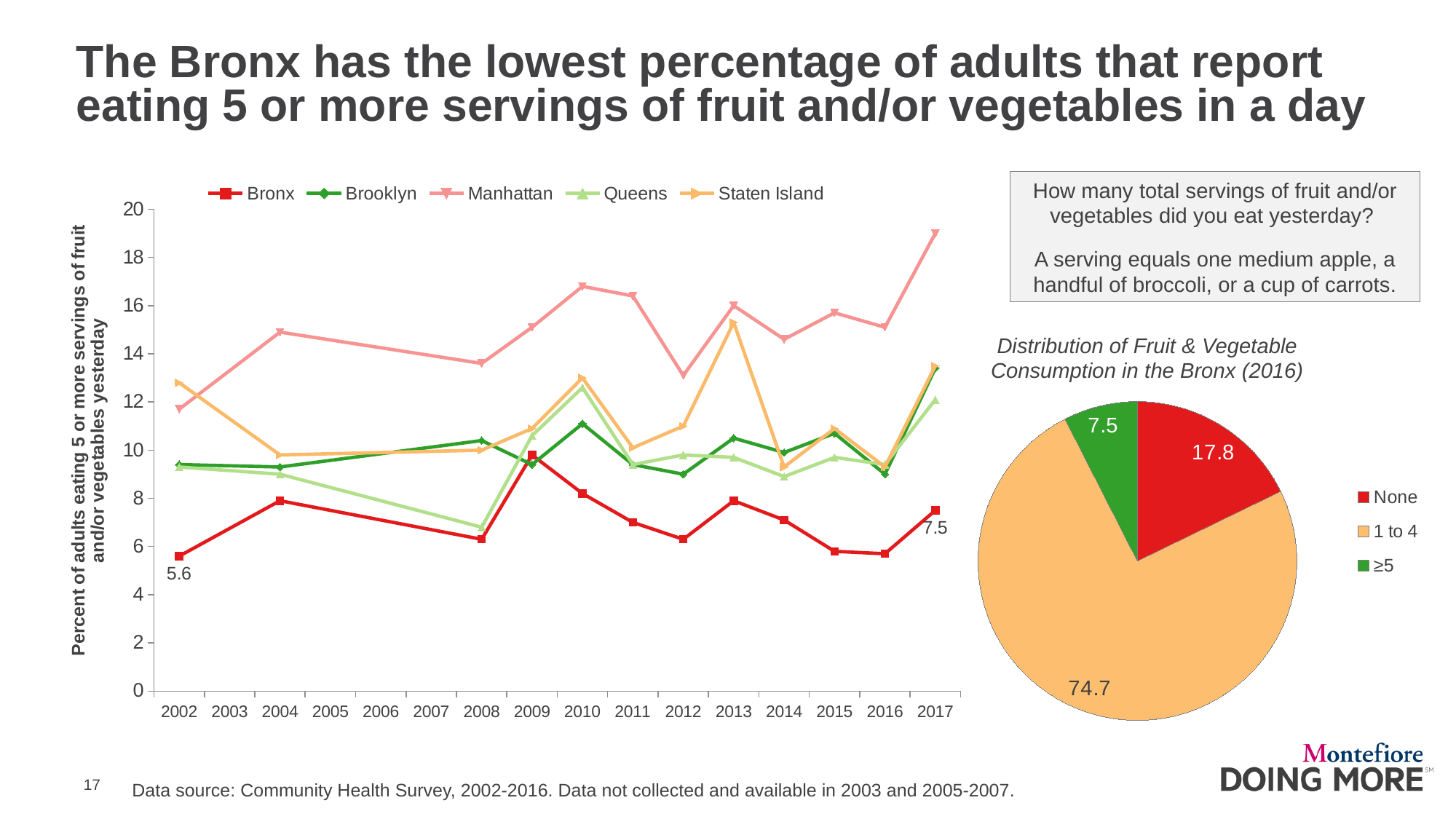
In the line chart on the left, which borough has the highest value in 2017? Manhattan In the line chart on the left, is the value for Manhattan in 2017 greater or less than 18? greater In the line chart on the left, what is the difference between the Bronx value in 2017 and in 2002? 1.9 In the line chart on the left, what is the value for the Bronx in 2002? 5.6 In the line chart on the left, is the value for the Bronx in 2012 greater or less than 8? less In the pie chart 'Distribution of Fruit & Vegetable Consumption in the Bronx (2016)', how many slices are there? 3 In the pie chart 'Distribution of Fruit & Vegetable Consumption in the Bronx (2016)', what is the value for '1 to 4'? 74.7 In the line chart on the left, how many series does the legend list? 5 In the pie chart 'Distribution of Fruit & Vegetable Consumption in the Bronx (2016)', what is the value for 'None'? 17.8 In the line chart on the left, what is the value for the Bronx in 2017? 7.5 What kind of chart is the chart on the left of the slide? Line chart In the pie chart 'Distribution of Fruit & Vegetable Consumption in the Bronx (2016)', which category has the smallest slice? ≥5